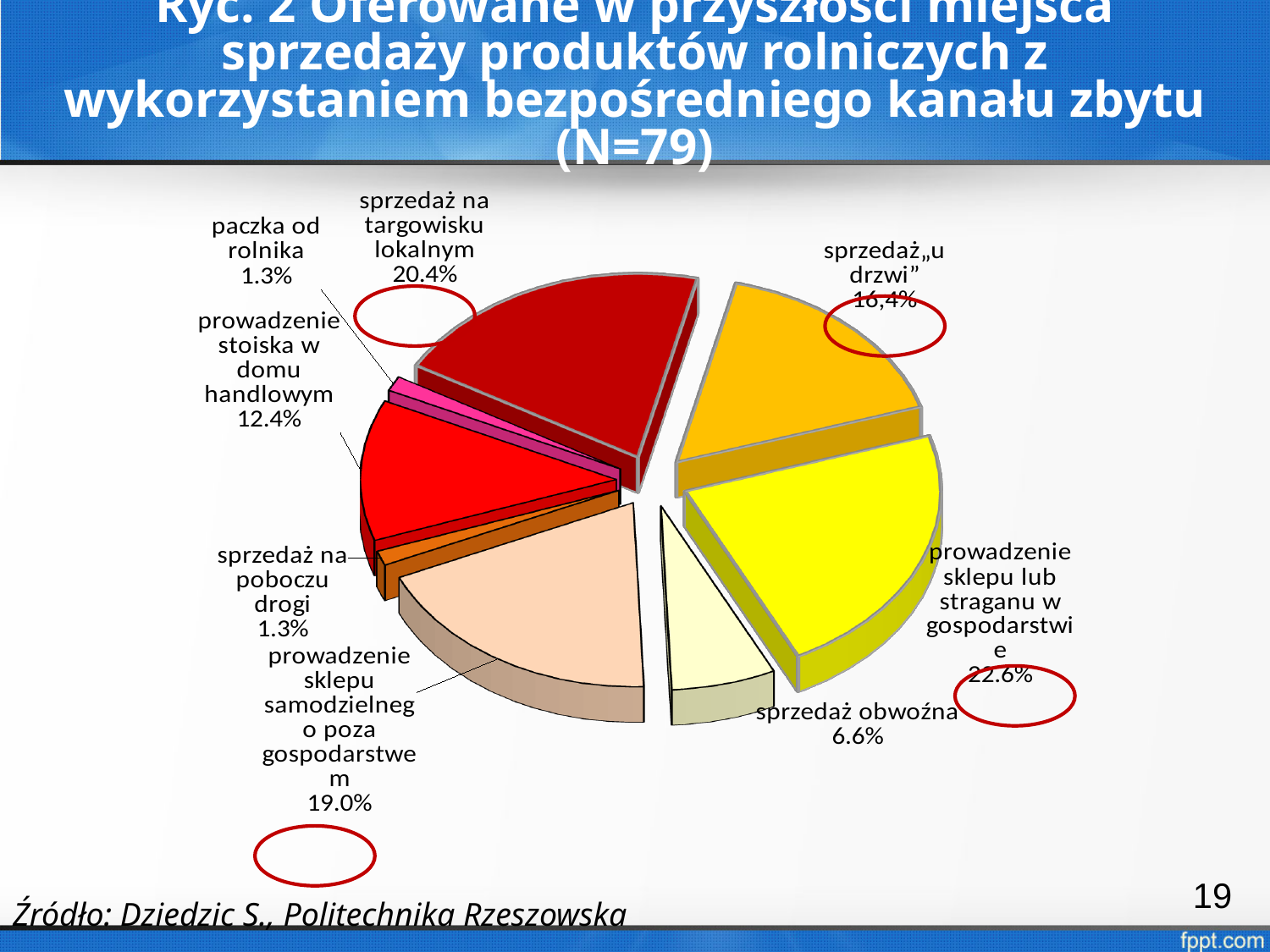
What percentage is shown for "sprzedaż obwoźna"? 6.6% What percentage is shown for "paczka od rolnika"? 1.3% What percentage is shown for "sprzedaż na targowisku lokalnym"? 20.4% What percentage is shown for "prowadzenie stoiska w domu handlowym"? 12.4% Which is larger: the share for "sprzedaż na targowisku lokalnym" or for "prowadzenie sklepu samodzielnego poza gospodarstwem"? sprzedaż na targowisku lokalnym What is the difference in percentage points between "prowadzenie sklepu lub straganu w gospodarstwie" and "sprzedaż na targowisku lokalnym"? 2.2 percentage points Which category has the largest share of the pie? prowadzenie sklepu lub straganu w gospodarstwie What type of chart is shown on the slide? pie chart How many categories (slices) does the pie chart have? 8 What percentage is shown for "prowadzenie sklepu lub straganu w gospodarstwie"? 22.6% What percentage is shown for "prowadzenie sklepu samodzielnego poza gospodarstwem"? 19.0% What sample size (N) is given in the chart title? N=79